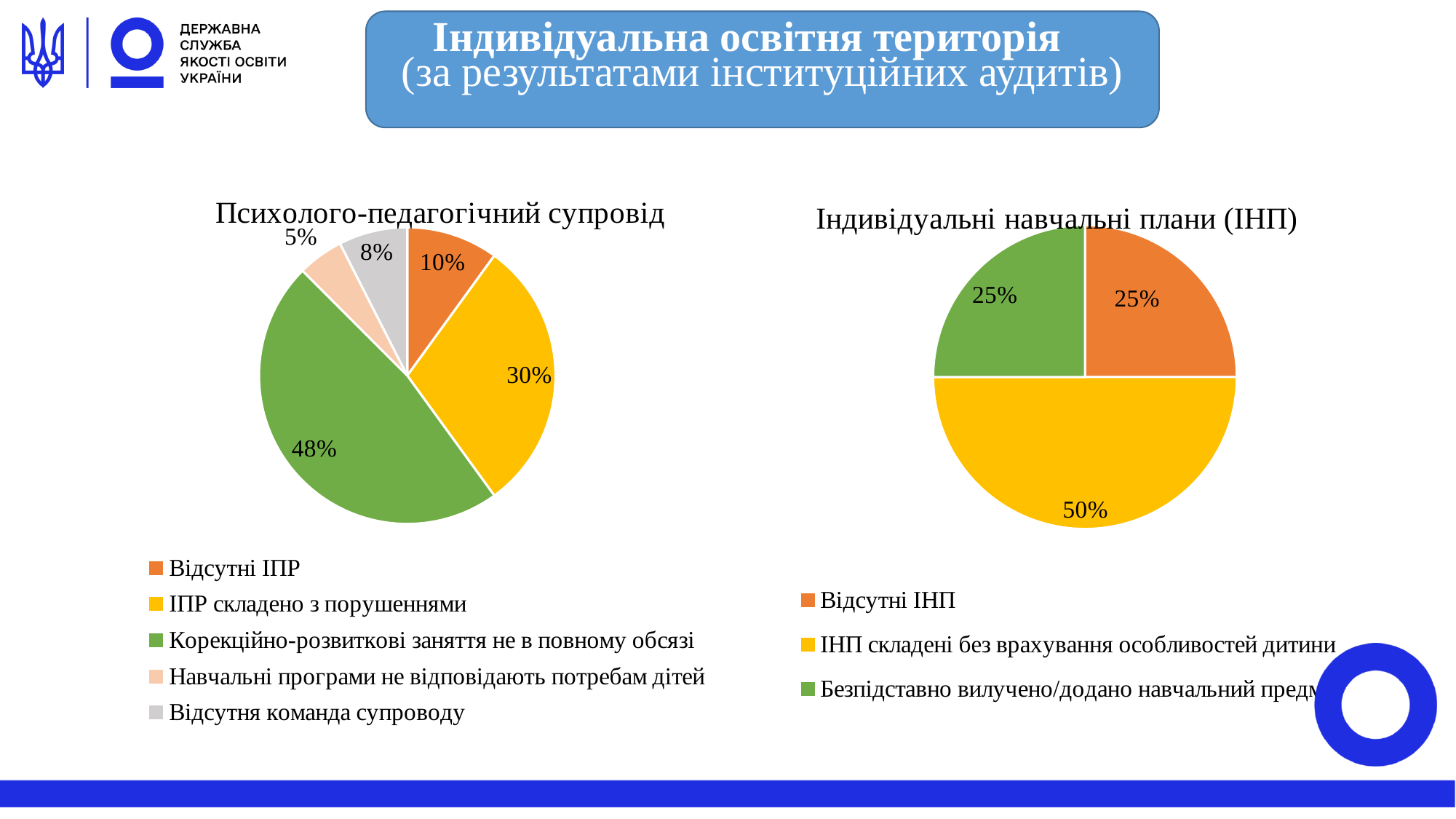
In the "Індивідуальні навчальні плани (ІНП)" chart, what share is labelled for "Відсутні ІНП"? 25% In the "Індивідуальні навчальні плани (ІНП)" chart, how many slices does the pie have? 3 In the "Індивідуальні навчальні плани (ІНП)" chart, what share is labelled for "ІНП складені без врахування особливостей дитини"? 50% In the "Психолого-педагогічний супровід" chart, what share is labelled for "Корекційно-розвиткові заняття не в повному обсязі"? 48% In the "Психолого-педагогічний супровід" chart, how many slices does the pie have? 5 In the "Психолого-педагогічний супровід" chart, what is the difference between the shares for "ІПР складено з порушеннями" and "Відсутня команда супроводу"? 22% In the "Психолого-педагогічний супровід" chart, which category has the smallest slice? Навчальні програми не відповідають потребам дітей In the "Психолого-педагогічний супровід" chart, which is larger: "Відсутня команда супроводу" or "Відсутні ІПР"? Відсутні ІПР What kind of chart is the "Психолого-педагогічний супровід" chart? pie chart In the "Психолого-педагогічний супровід" chart, which category has the largest slice? Корекційно-розвиткові заняття не в повному обсязі In the "Індивідуальні навчальні плани (ІНП)" chart, what colour is the slice for "Відсутні ІНП"? orange